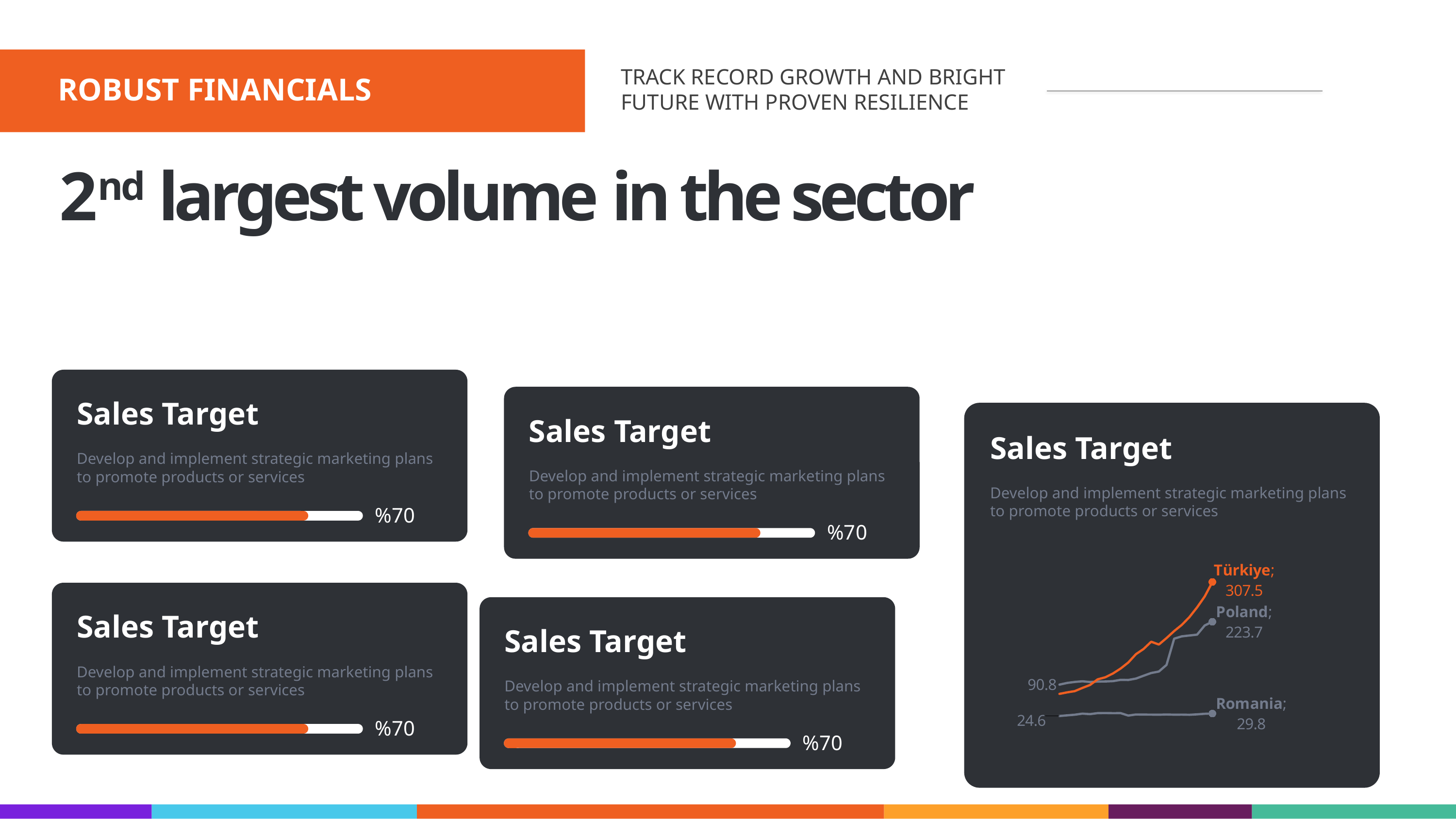
What kind of chart is shown in the Sales Target card on the right of the slide? line chart How many country lines are plotted in the line chart on the right? 3 In the line chart on the right, what is the final value labelled for Romania? 29.8 In the line chart on the right, what is the difference between the final values of Türkiye and Poland? 83.8 In the line chart on the right, which has the larger final value, Poland or Romania? Poland In the line chart on the right, what is the difference between the final values of Poland and Romania? 193.9 In the line chart on the right, what is the starting value labelled for the Romania line? 24.6 In the line chart on the right, which country ends with the highest value? Türkiye In the line chart on the right, does the Türkiye line rise or fall from left to right? rise In the line chart on the right, which country ends with the lowest value? Romania In the line chart on the right, what is the final value labelled for Poland? 223.7 In the line chart on the right, what is the final value labelled for Türkiye? 307.5